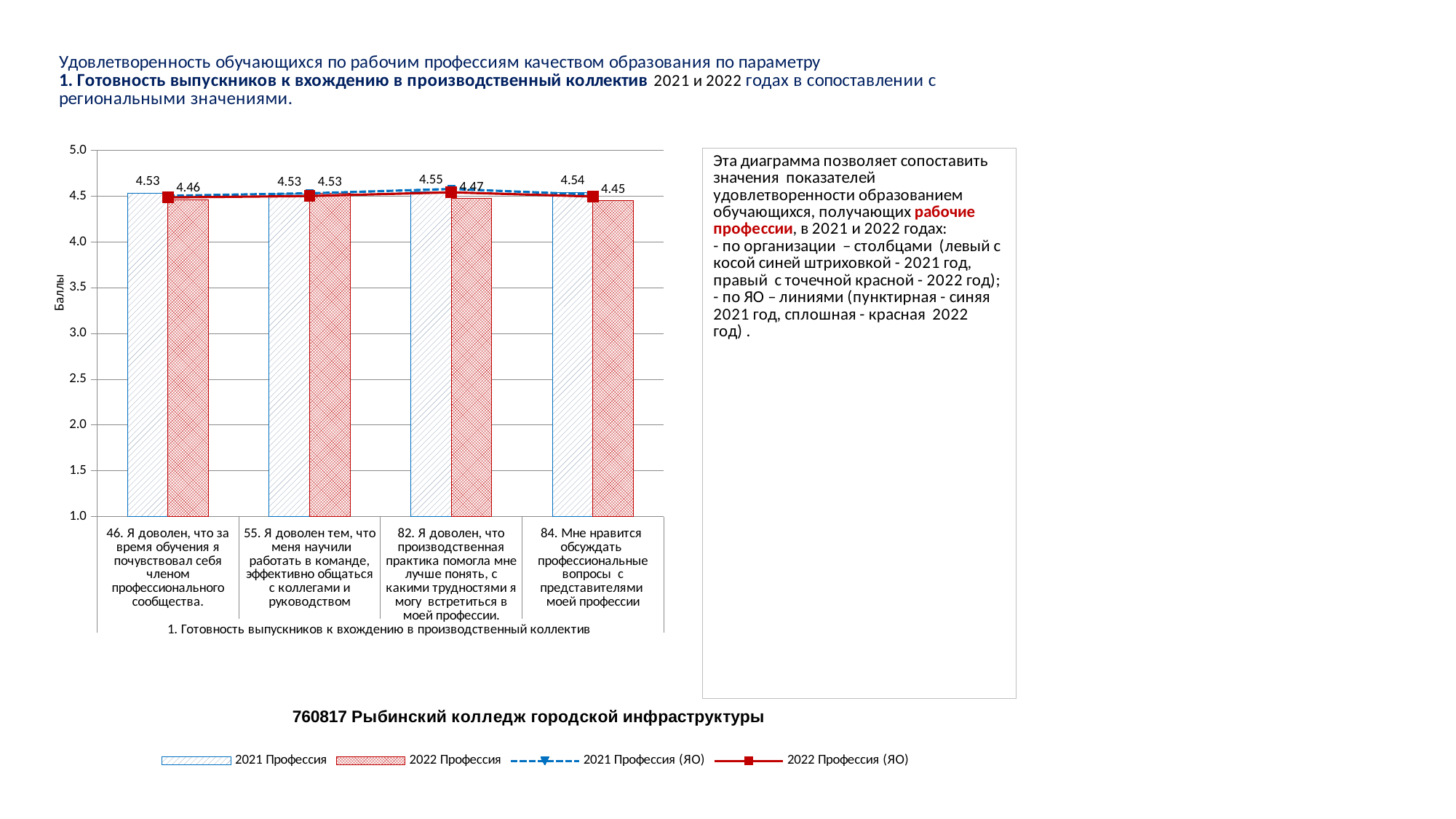
What is the difference between the 2021 Профессия and 2022 Профессия values for category 46? 0.07 Which category has the highest 2021 Профессия value? 82. Я доволен, что производственная практика помогла мне лучше понять, с какими трудностями я могу встретиться в моей профессии. Is the 2022 Профессия value for category 46 greater or less than 4.0? greater How many categories (questions) are shown on the x axis of the chart? 4 What is the value of the 2021 Профессия bar for category 46 (Я доволен, что за время обучения я почувствовал себя членом профессионального сообщества)? 4.53 Which category has the lowest 2022 Профессия value? 84. Мне нравится обсуждать профессиональные вопросы с представителями моей профессии What is the value of the 2022 Профессия bar for category 82 (Я доволен, что производственная практика помогла мне лучше понять...)? 4.47 What kind of chart is shown on the slide? combination bar and line chart How many series does the chart legend list? 4 What is the label of the vertical axis of the chart? Баллы For category 84, which is larger: the 2021 Профессия value or the 2022 Профессия value? 2021 Профессия What is the value of the 2022 Профессия bar for category 84 (Мне нравится обсуждать профессиональные вопросы с представителями моей профессии)? 4.45